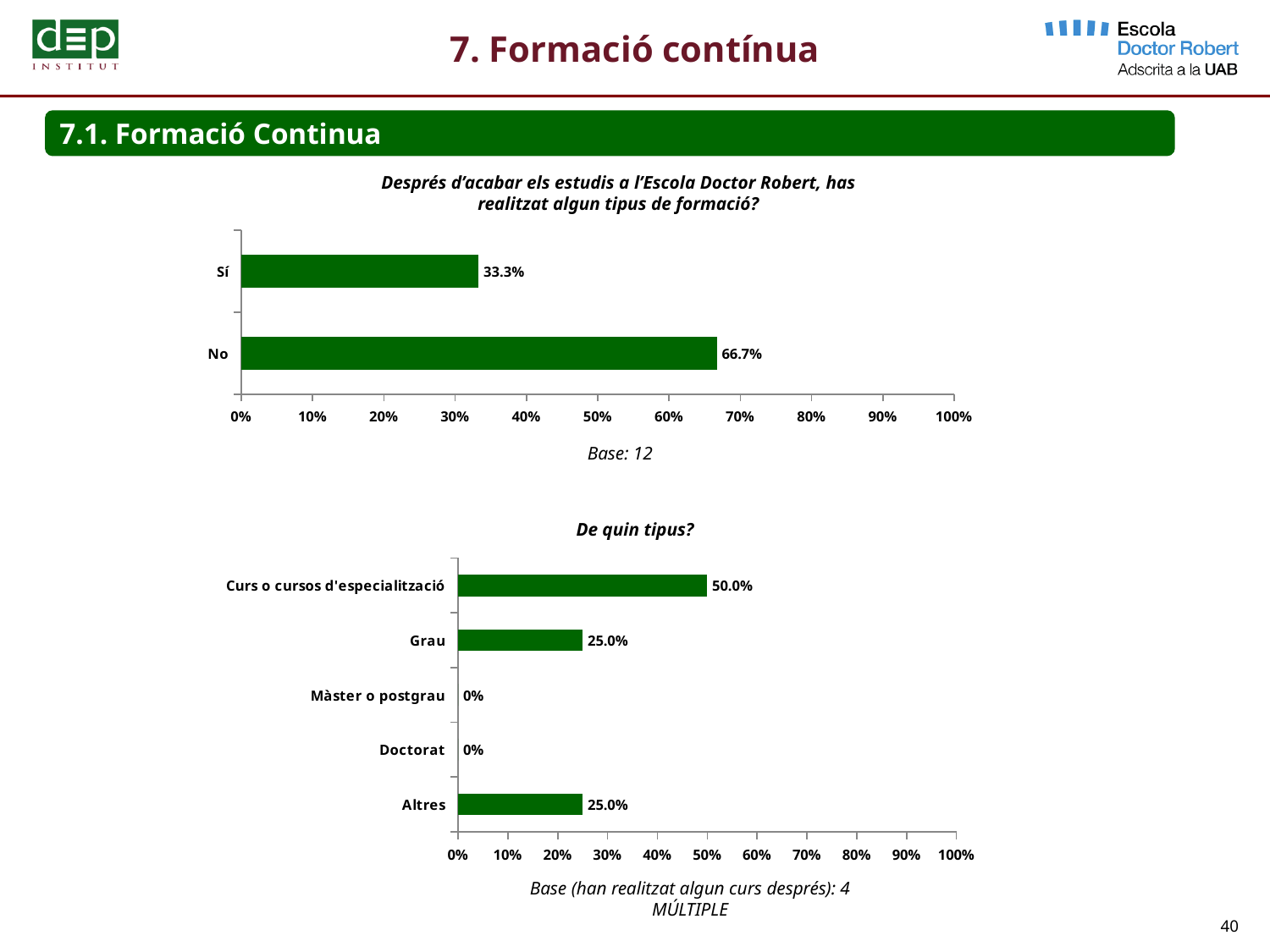
In the top chart, what is the value for "Sí"? 33.3% In the top chart, how many categories are shown? 2 In the bottom chart, how many categories are shown? 5 In the bottom chart ("De quin tipus?"), what is the value for "Curs o cursos d'especialització"? 50.0% In the bottom chart, what is the value for "Grau"? 25.0% In the bottom chart, what is the value for "Doctorat"? 0% In the top chart ("Després d'acabar els estudis a l'Escola Doctor Robert, has realitzat algun tipus de formació?"), what is the value for "No"? 66.7% In the bottom chart, what is the difference between the values for "Curs o cursos d'especialització" and "Altres"? 25.0% In the bottom chart, which category has the highest value? Curs o cursos d'especialització In the top chart, what is the difference between the values for "No" and "Sí"? 33.4% What kind of chart is the top chart? Bar chart In the top chart, which category has the higher value, "Sí" or "No"? No